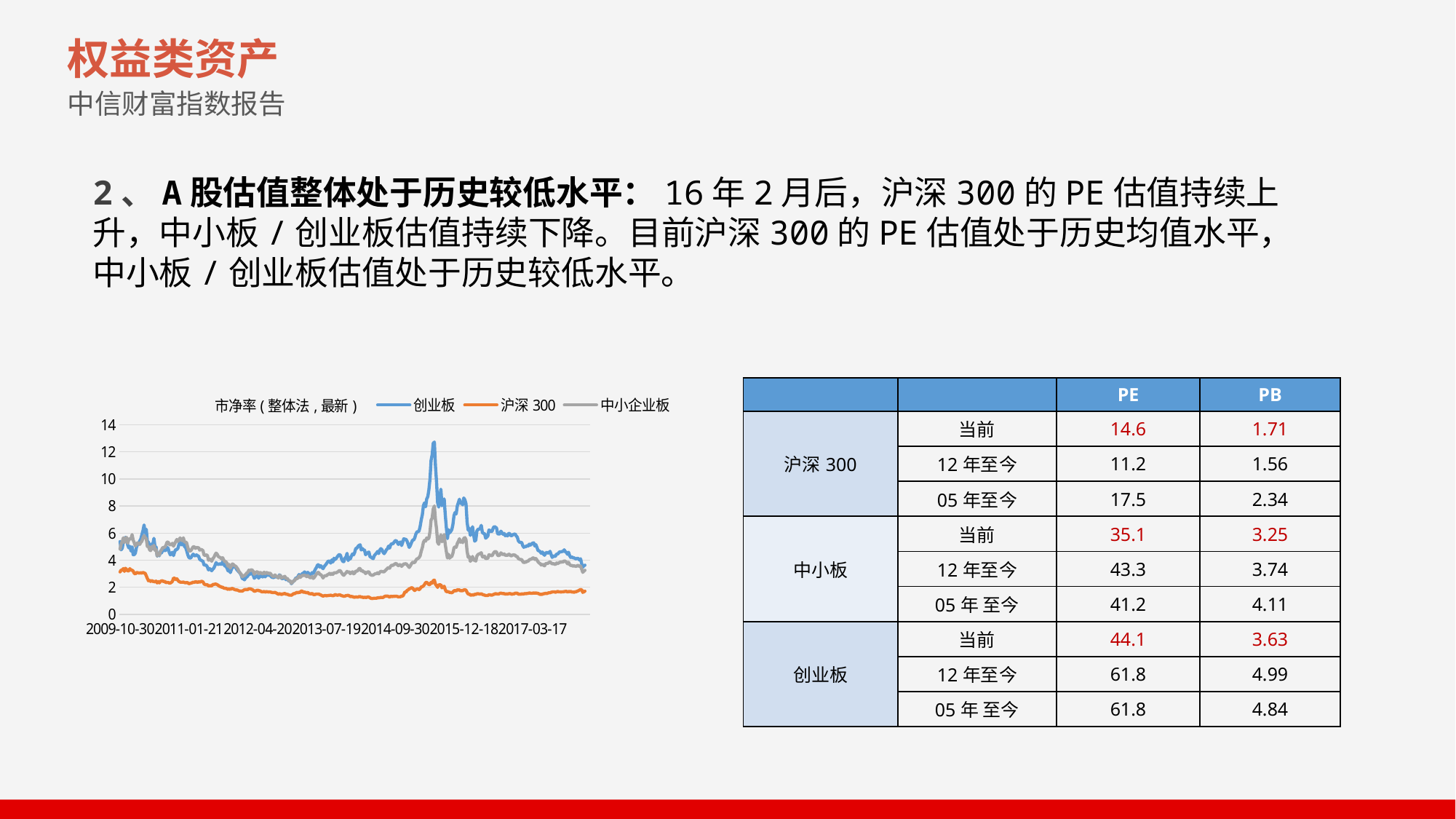
What colour is the 沪深 300 line in the line chart? orange What kind of chart is shown on the left of the slide? line chart Is the highest value of 沪深 300 in the line chart greater or less than 4? less How many series does the legend of the line chart list? 3 Is the peak value of 创业板 in the line chart greater or less than 12? greater What is the title of the line chart? 市净率（整体法，最新） How many date labels are shown on the x axis of the line chart? 7 Is the value of 创业板 at the right end of the line chart greater or less than 6? less Does the 创业板 line rise or fall from its 2015 peak to the end of the chart? fall In the line chart, which series is higher at the 2015 peak, 创业板 or 沪深 300? 创业板 Which series in the line chart reaches the highest value over the whole period? 创业板 Which series in the line chart stays lowest over the whole period? 沪深 300